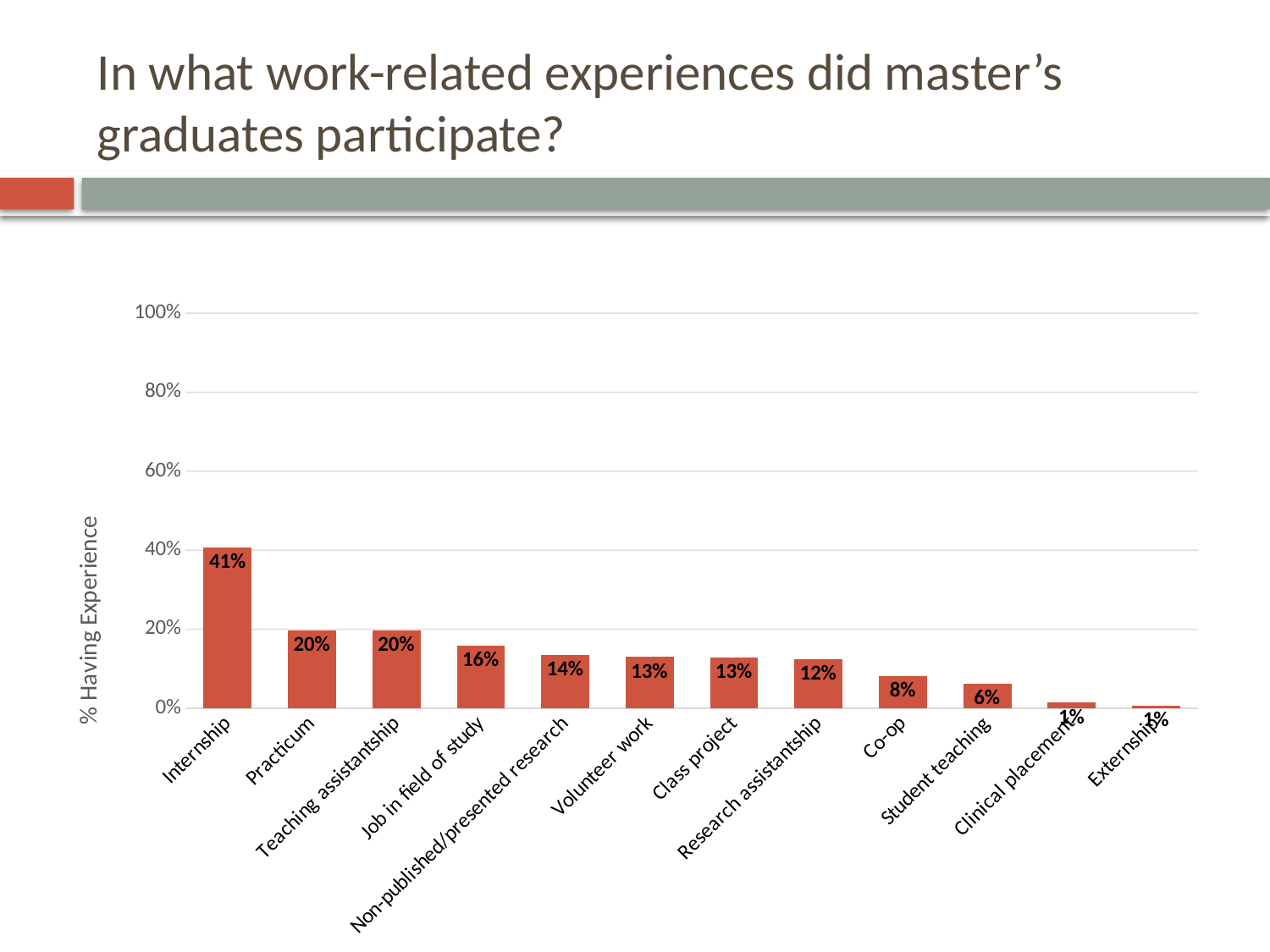
How many categories are shown on the x axis? 12 What is the value shown for Co-op? 8% What is the difference between the values for Internship and Practicum? 21% What is the value shown for Student teaching? 6% Is the value for Internship greater or less than 40%? greater What kind of chart is shown on the slide? Bar chart What is the difference between the values for Research assistantship and Co-op? 4% What is the label of the vertical axis? % Having Experience What is the value shown for Job in field of study? 16% Which work-related experience has the highest percentage? Internship Which is larger, the value for Job in field of study or the value for Volunteer work? Job in field of study What percentage of master's graduates participated in an internship? 41%